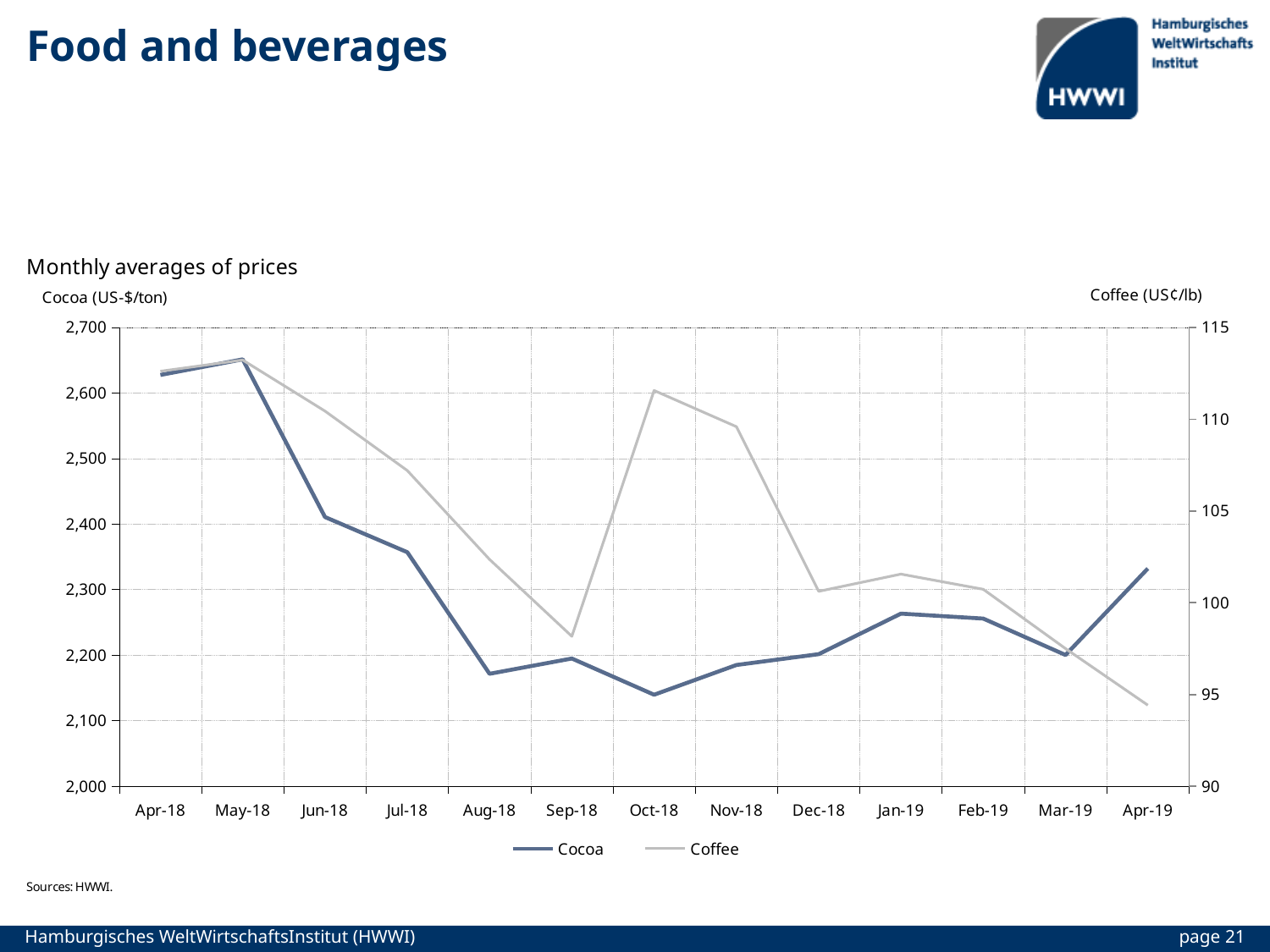
How many series does the legend list? 2 Is the Coffee price in Oct-18 greater or less than 110? greater In which month is the Cocoa price lowest? Oct-18 Which is larger, the Cocoa price in Jan-19 or in Mar-19? Jan-19 Does the Cocoa price rise or fall from May-18 to Aug-18? fall What unit is shown on the left axis for Cocoa? US-$/ton How many months are plotted along the x axis? 13 Is the Coffee price in Sep-18 greater or less than 100? less What kind of chart is shown on the slide? line chart In which month is the Cocoa price highest? May-18 Is the Cocoa price in Jul-18 greater or less than 2,400? less In which month is the Coffee price lowest? Apr-19